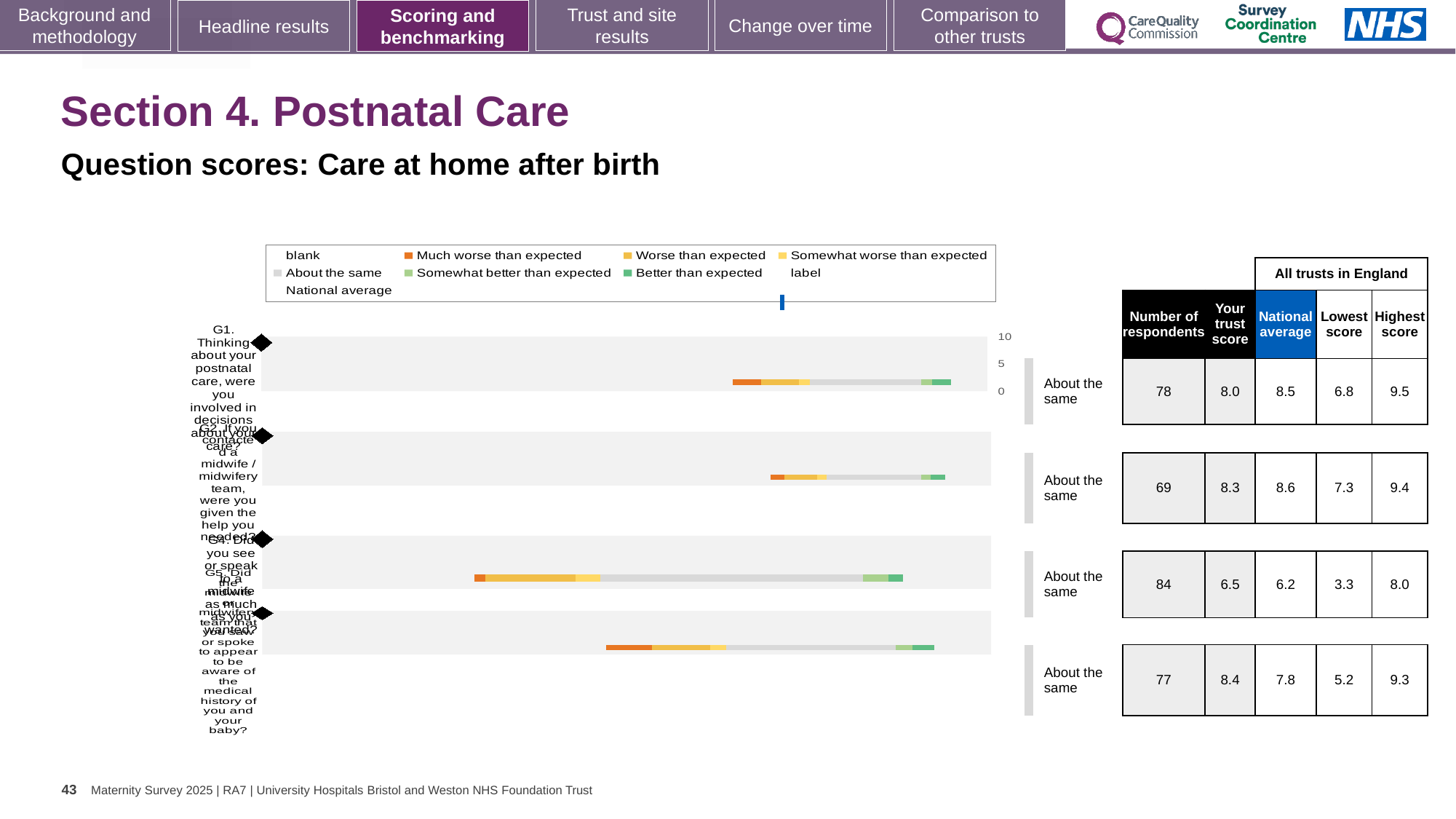
For question G5, what is the difference between 'Your trust score' and the National average? 0.6 Which question has the lowest 'Your trust score' in the table? G4 Which question has the highest 'Your trust score' in the table? G5 What is the 'Your trust score' for question G1 in the table next to the chart? 8.0 How many questions (bars) are plotted in the chart? 4 How many respondents are listed for question G4? 84 How many entries does the chart legend list? 9 What is the Highest score across all trusts in England for question G1? 9.5 For question G2, which is larger: 'Your trust score' or the National average? National average What is the National average for question G4 in the table next to the chart? 6.2 What kind of chart is shown on the slide? Bar chart What benchmark category is shown beside each bar in the chart? About the same